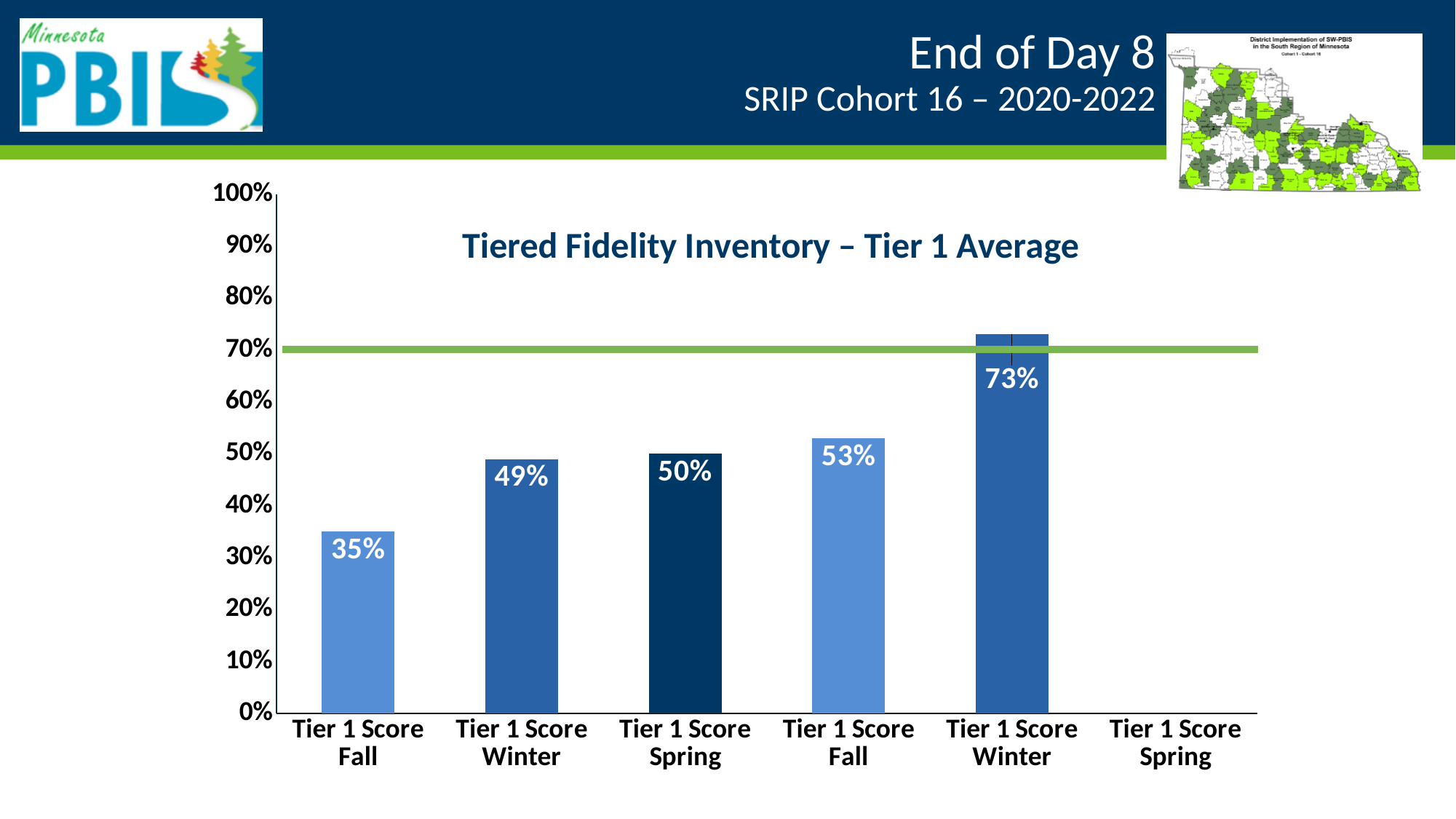
What is the value of the Tier 1 Score Spring bar (third bar from the left)? 50% Which bar has the highest value? The second Tier 1 Score Winter bar (73%) What is the value of the second Tier 1 Score Winter bar (fifth bar from the left)? 73% What is the value of the first Tier 1 Score Fall bar (the leftmost bar)? 35% Do the bar values rise or fall from left to right across the x axis? Rise What type of chart is shown on the slide? Bar chart What is the value of the first Tier 1 Score Winter bar (second bar from the left)? 49% Which bar has the lowest value? The first Tier 1 Score Fall bar (35%) How many bars are plotted on the chart? 5 Which is larger, the second Tier 1 Score Fall bar or the first Tier 1 Score Winter bar? The second Tier 1 Score Fall bar (53%) What is the value of the second Tier 1 Score Fall bar (fourth bar from the left)? 53% What is the difference between the highest bar (73%) and the lowest bar (35%)? 38 percentage points